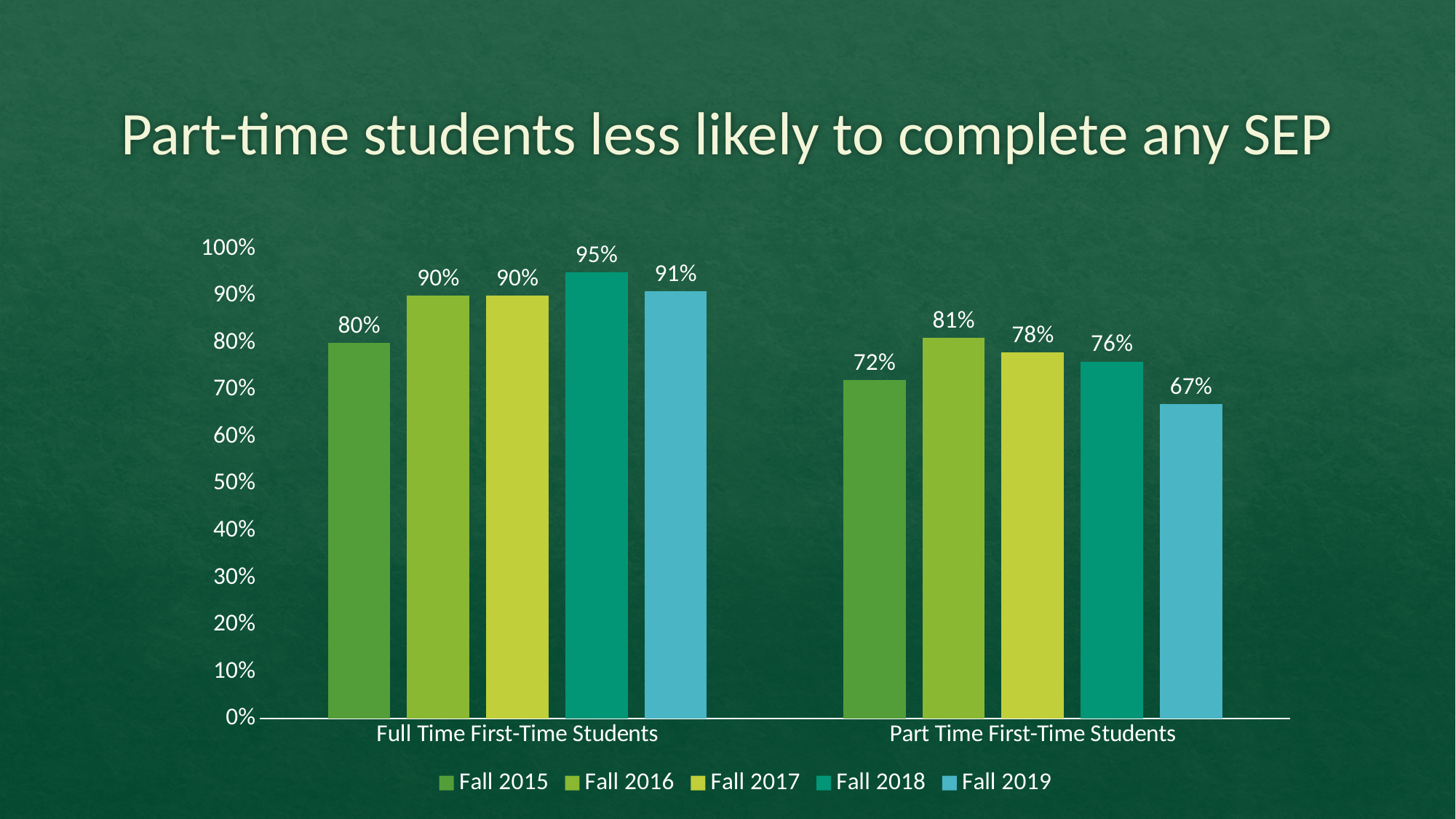
What is the value for Fall 2015 among Part Time First-Time Students? 72% What is the value for Fall 2019 among Part Time First-Time Students? 67% Which is larger: the Fall 2016 value for Full Time First-Time Students or for Part Time First-Time Students? Full Time First-Time Students Which series has the lowest value for Part Time First-Time Students? Fall 2019 What is the value for Fall 2018 among Full Time First-Time Students? 95% What kind of chart is shown on the slide? bar chart What is the title of the slide? Part-time students less likely to complete any SEP How many series does the legend list? 5 What is the difference between the Fall 2018 values for Full Time First-Time Students and Part Time First-Time Students? 19% How many categories are shown on the x axis? 2 Which series has the highest value for Full Time First-Time Students? Fall 2018 Is the Fall 2019 value for Part Time First-Time Students greater or less than 70%? less